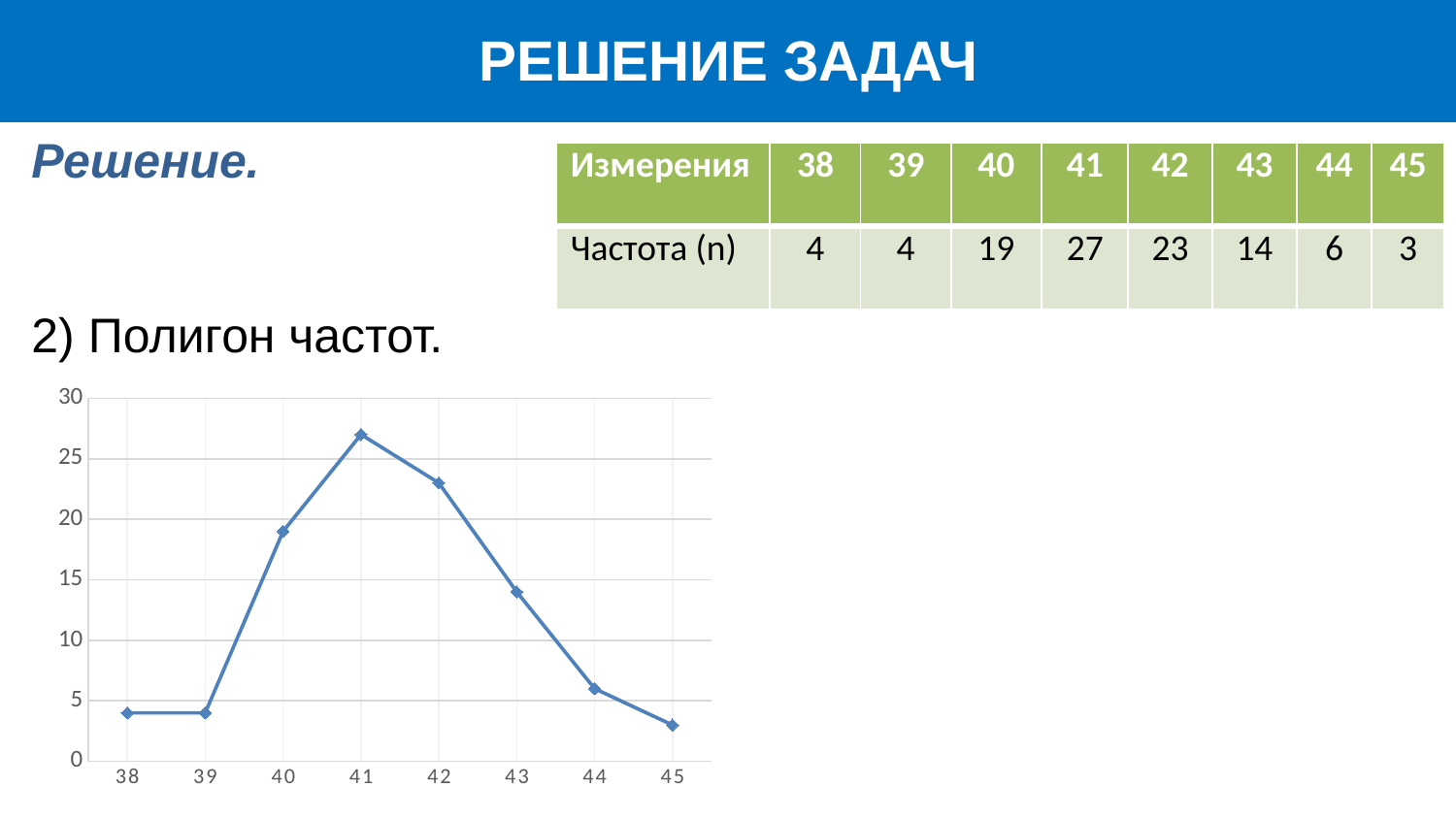
Do the values rise or fall from 41 to 45 along the x axis? fall What is the highest tick value shown on the vertical axis? 30 What is the frequency value plotted at 40? 19 At which x value does the chart reach its highest point? 41 What kind of chart is shown on the slide? line chart What is the difference between the values at 41 and 42? 4 Which is larger, the value at 40 or the value at 43? 40 What is the frequency value plotted at 44? 6 How many data points are plotted on the chart? 8 Is the value at 42 greater or less than 20? greater At which x value does the chart reach its lowest point? 45 What is the frequency value plotted at 41? 27